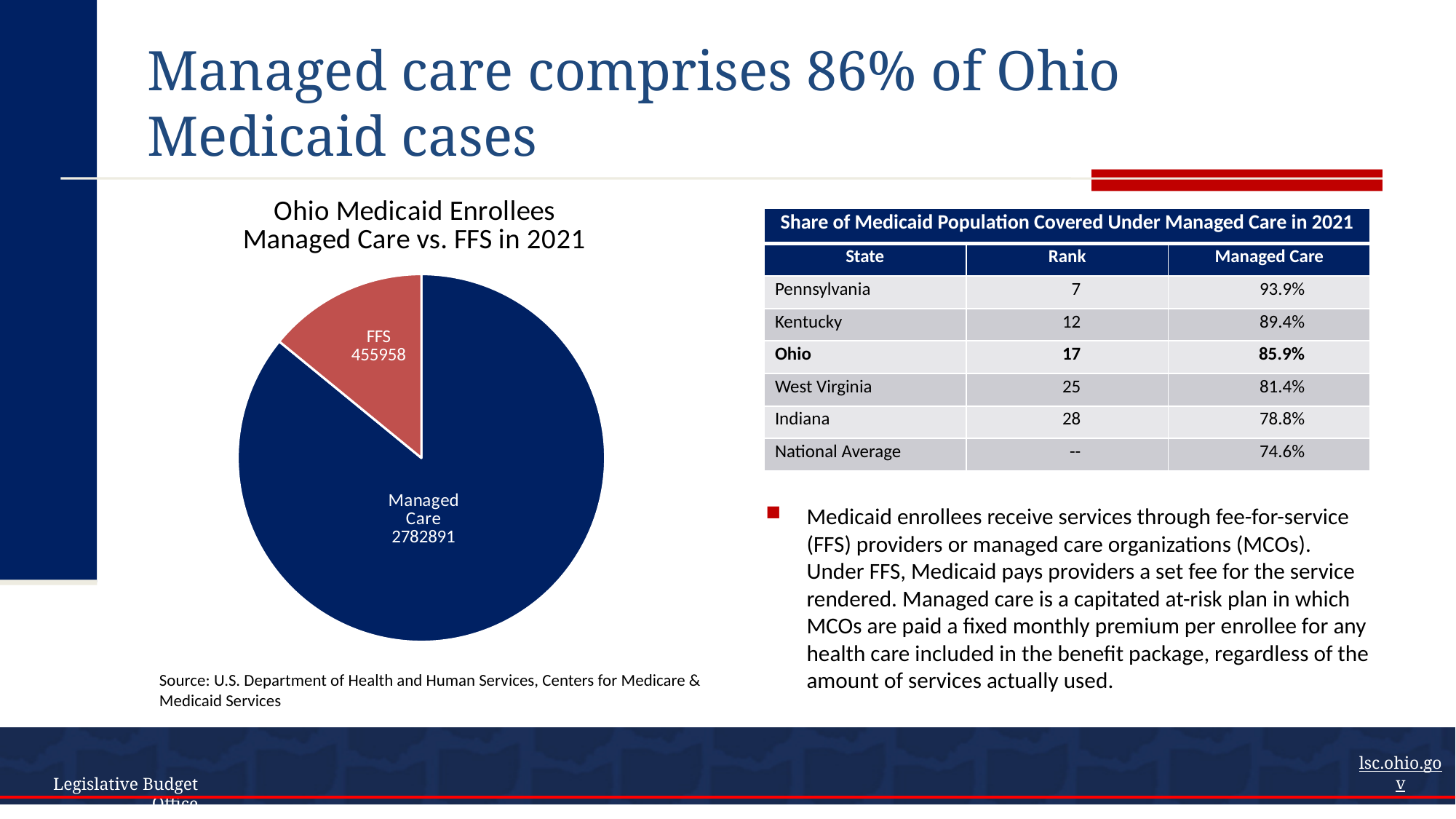
What colour is the FFS slice in the pie chart? red Which slice of the pie chart is the smallest? FFS What type of chart is shown on the slide? pie chart How many slices does the pie chart have? 2 Which slice of the pie chart is the largest? Managed Care What is the difference between the Managed Care and FFS values in the pie chart? 2326933 What is the value shown for FFS in the pie chart? 455958 What is the total of the two values shown in the pie chart? 3238849 Which is larger in the pie chart, Managed Care or FFS? Managed Care What is the title of the pie chart? Ohio Medicaid Enrollees Managed Care vs. FFS in 2021 What is the value shown for Managed Care in the pie chart? 2782891 What share of the pie does the Managed Care slice represent, to one decimal place? 85.9%